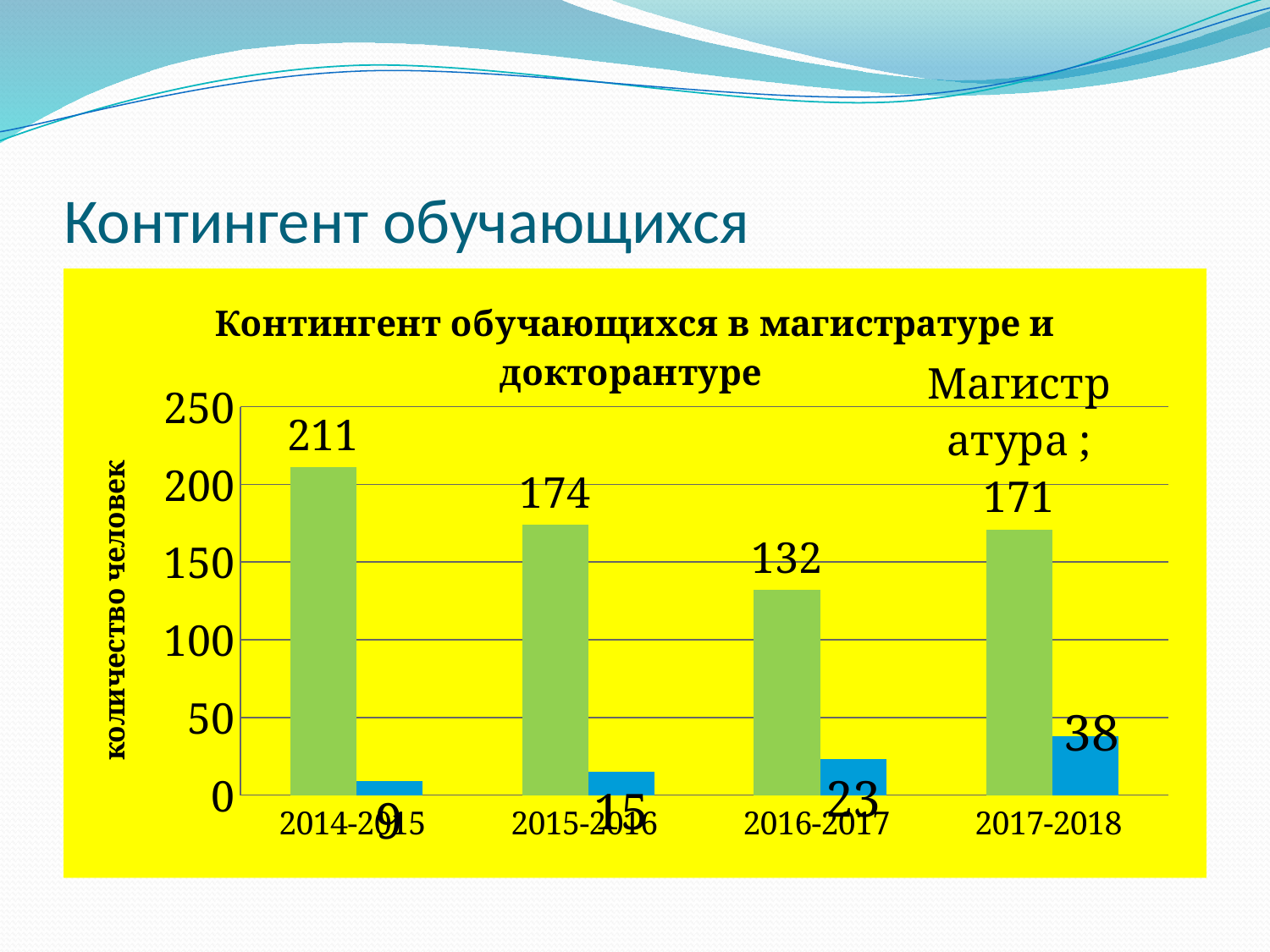
What is the difference between the green bar values for 2014-2015 and 2015-2016? 37 Do the blue bar values rise or fall from 2014-2015 to 2017-2018? rise What type of chart is shown on the slide? bar chart What is the value of the blue bar for 2017-2018? 38 What is the value of the blue bar for 2015-2016? 15 What is the value of the green bar for 2016-2017? 132 What is the label of the vertical axis? количество человек Which is larger: the green bar for 2015-2016 or the green bar for 2017-2018? 2015-2016 In which academic year is the green bar highest? 2014-2015 How many academic years are shown on the x axis? 4 In which academic year is the blue bar lowest? 2014-2015 What is the value of the green bar for 2014-2015? 211